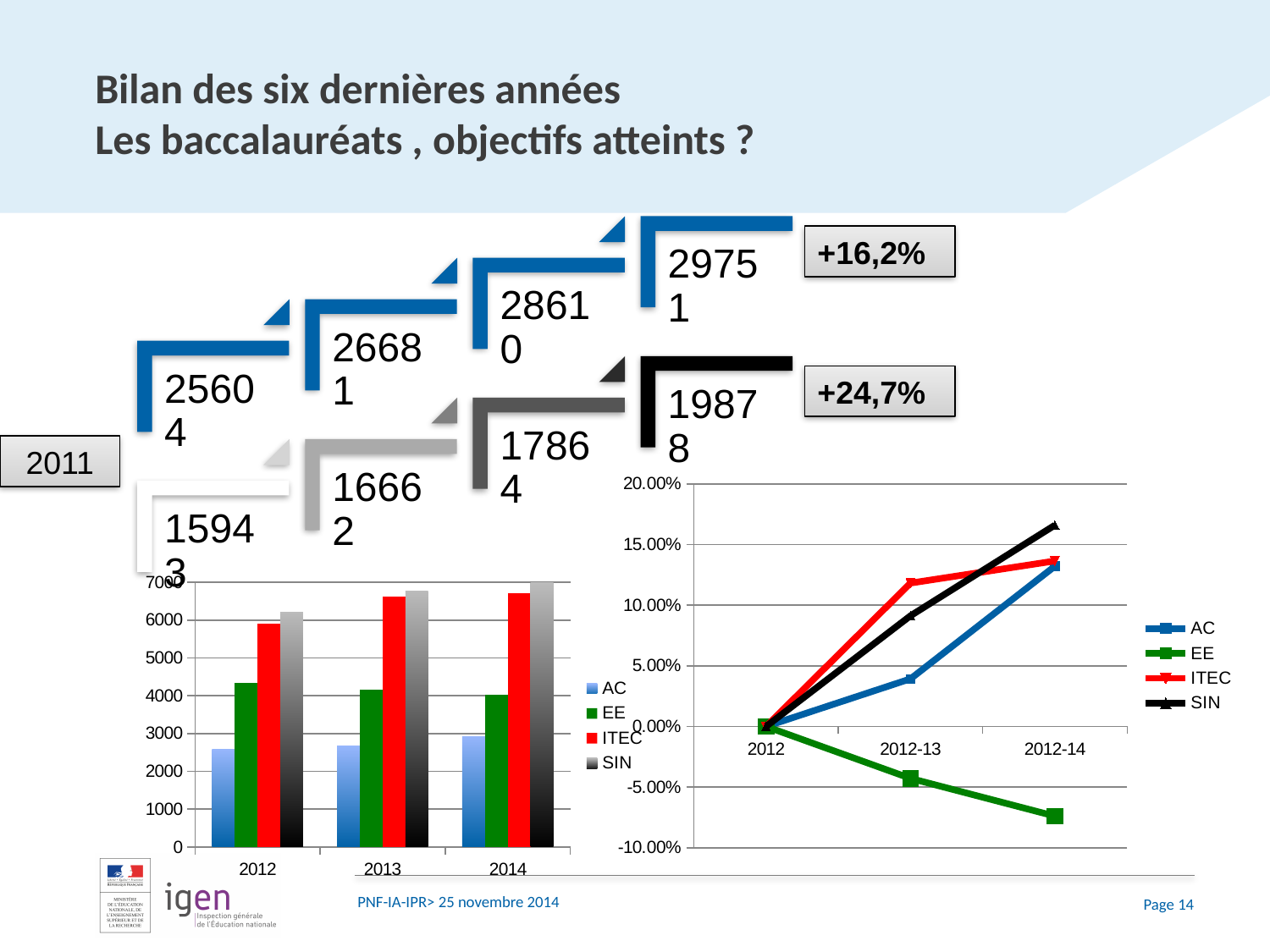
In the bar chart at the bottom left, which series has the lowest value in 2012? AC In the line chart at the bottom right, is the value for EE at 2012-14 greater or less than -5.00%? less In the line chart at the bottom right, which series has the lowest value at 2012-14? EE What kind of chart is the chart at the bottom left of the slide? bar chart In the bar chart at the bottom left, is the value for AC in 2012 greater or less than 3000? less In the line chart at the bottom right, which is larger at 2012-13, ITEC or AC? ITEC In the bar chart at the bottom left, how many year categories are shown on the x axis? 3 In the bar chart at the bottom left, is the value for SIN in 2014 greater or less than 6000? greater What kind of chart is the chart at the bottom right of the slide? line chart In the bar chart at the bottom left, do the values for EE rise or fall from 2012 to 2014? fall In the bar chart at the bottom left, how many series does the legend list? 4 In the line chart at the bottom right, which series has the highest value at 2012-14? SIN